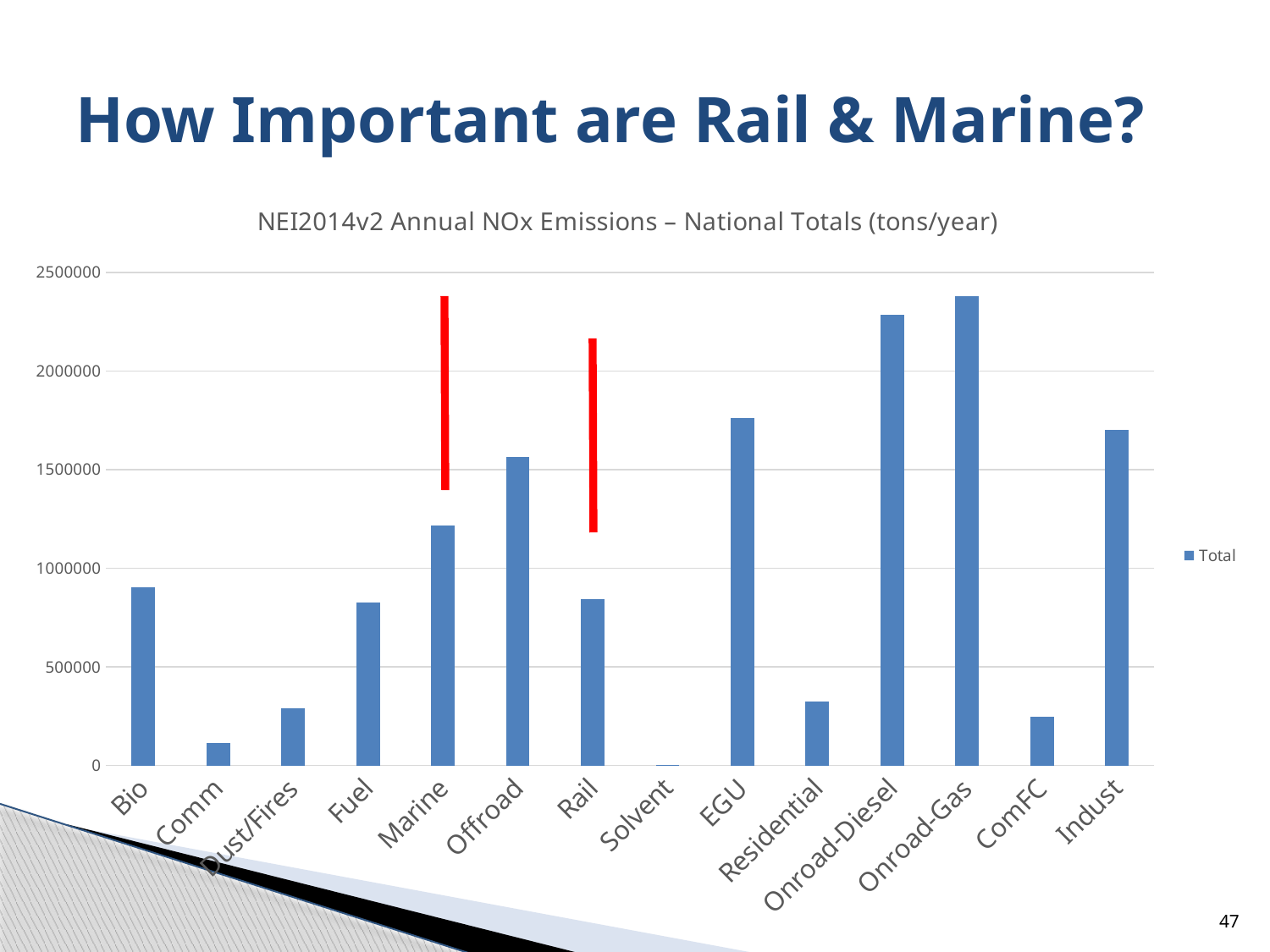
How many categories are shown on the x axis of the chart? 14 Is the value for Rail greater or less than 1000000? less How many series does the chart legend list? 1 Is the value for EGU greater or less than 1500000? greater What kind of chart is shown on the slide? bar chart Which has a larger value, Onroad-Diesel or EGU? Onroad-Diesel Which has a larger value, Marine or Rail? Marine What is the title of the chart? NEI2014v2 Annual NOx Emissions – National Totals (tons/year) Is the value for Marine greater or less than 1000000? greater Which category has the lowest value in the chart? Solvent What is the name of the series shown in the legend? Total Which category has the highest value in the chart? Onroad-Gas